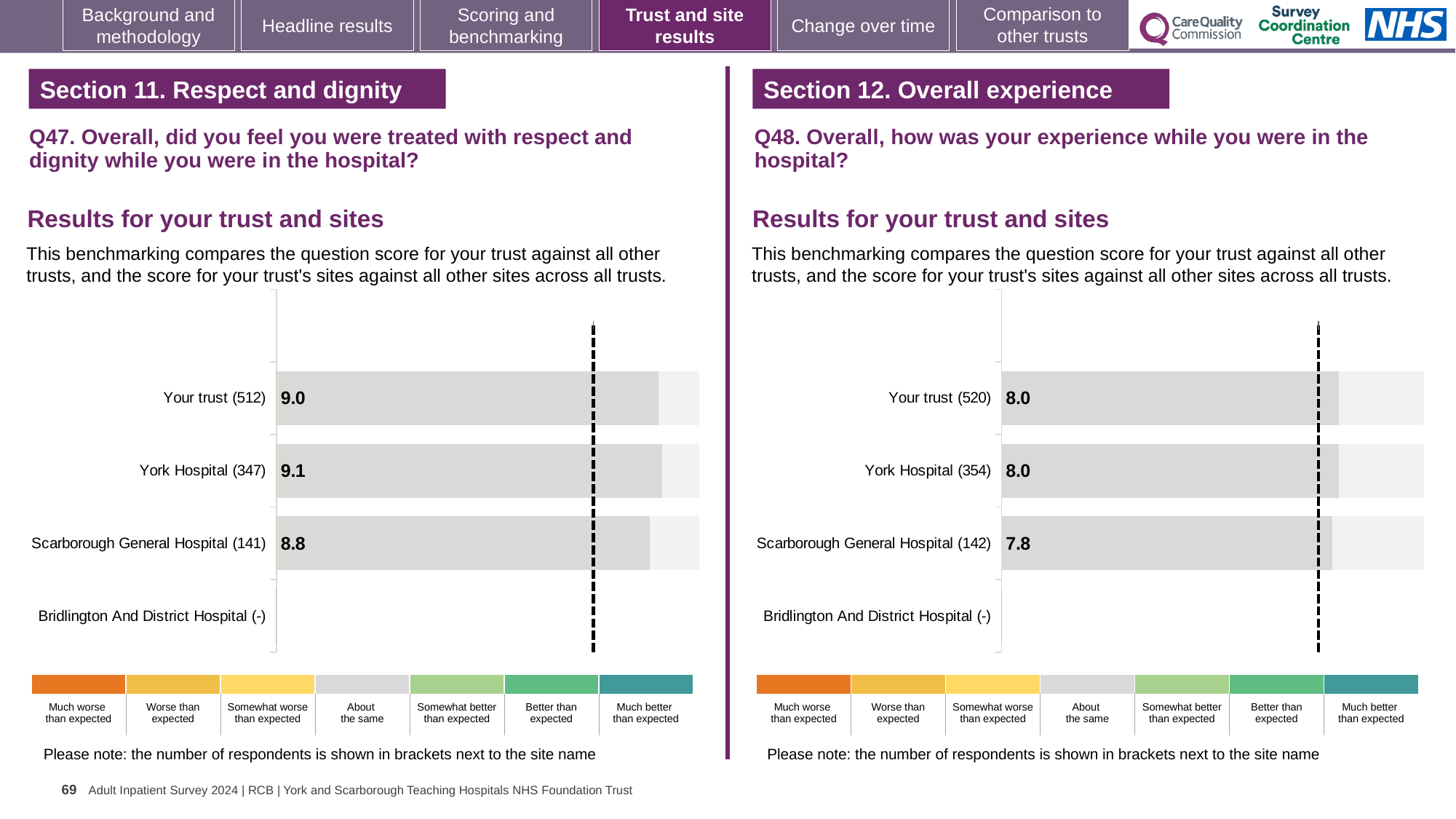
How many respondents are shown in brackets for York Hospital in the Q48 chart on the right? 354 In the Q47 chart on the left, what is the score for Your trust? 9.0 In the Q48 chart on the right, what is the difference between the Your trust score and the Scarborough General Hospital score? 0.2 In the Q48 chart on the right, what is the score for Scarborough General Hospital? 7.8 In the Q47 chart on the left, what is the score for York Hospital? 9.1 In the Q48 chart on the right, which site has the lowest score among those with a value shown? Scarborough General Hospital In the Q47 chart on the left, what is the difference between the York Hospital score and the Scarborough General Hospital score? 0.3 In the Q47 chart on the left, what is the score for Scarborough General Hospital? 8.8 In the Q47 chart on the left, which site or trust has the highest score? York Hospital In the Q48 chart on the right, what is the score for Your trust? 8.0 In the Q47 chart on the left, which has the larger score, Your trust or Scarborough General Hospital? Your trust What type of chart is used in the Q47 chart on the left? Bar chart